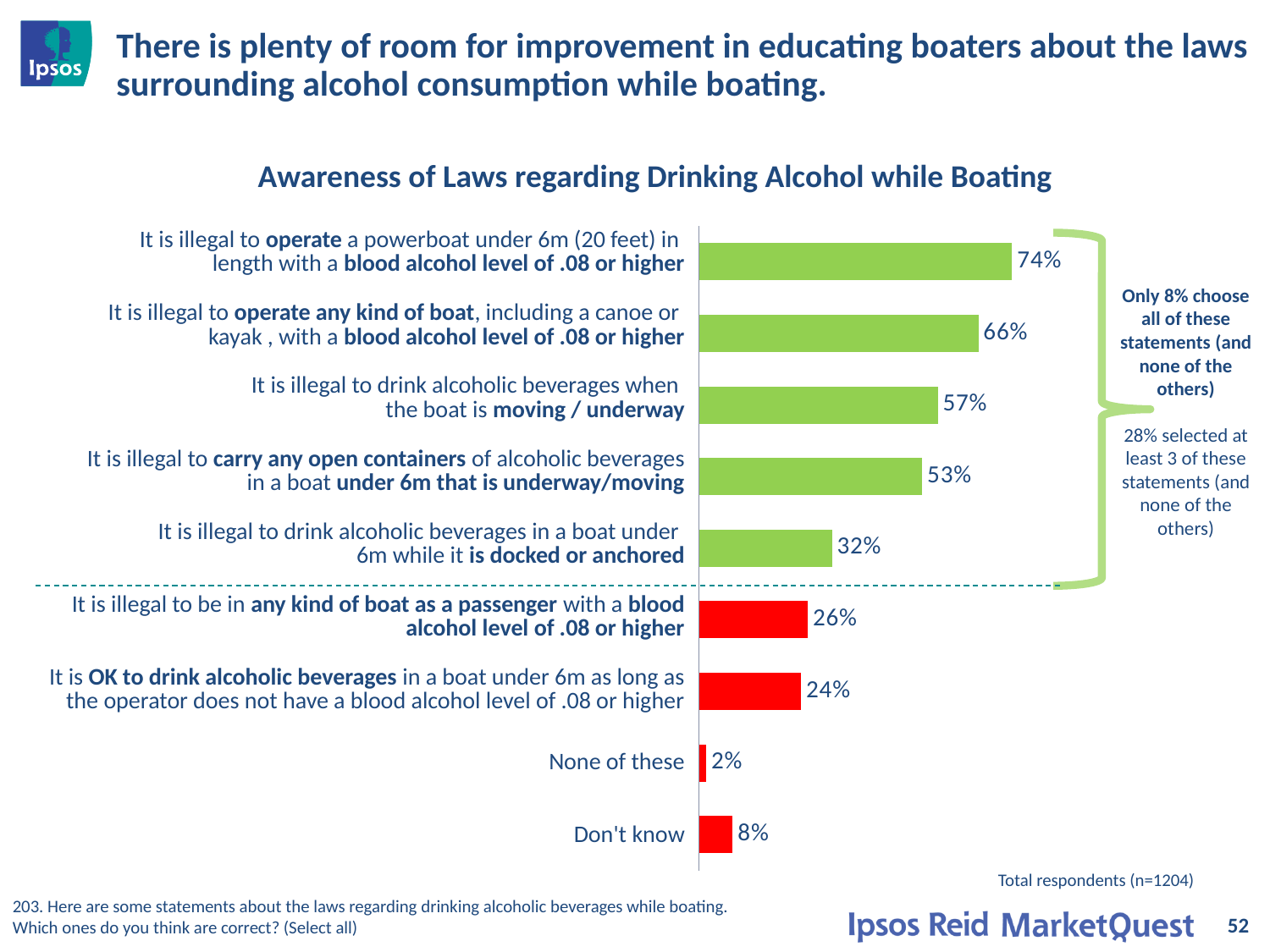
According to the annotation on the chart, what percentage of respondents chose all of the green statements and none of the others? 8% What percentage of respondents said it is illegal to drink alcoholic beverages in a boat under 6m while it is docked or anchored? 32% Which category has the lowest percentage? None of these What percentage of respondents selected 'Don't know'? 8% What is the title of the chart? Awareness of Laws regarding Drinking Alcohol while Boating What percentage of respondents said it is illegal to drink alcoholic beverages when the boat is moving / underway? 57% How many categories are shown in the chart? 9 What is the difference in percentage points between the 'operate any kind of boat' statement (66%) and the 'carry any open containers' statement (53%)? 13 What percentage of respondents said it is illegal to operate a powerboat under 6m in length with a blood alcohol level of .08 or higher? 74% Which statement has the highest percentage of respondents? It is illegal to operate a powerboat under 6m (20 feet) in length with a blood alcohol level of .08 or higher Which has a higher percentage: the statement about being a passenger with a blood alcohol level of .08 or higher, or the statement that it is OK to drink alcoholic beverages as long as the operator is under .08? The passenger statement (26%) What type of chart is shown on the slide? Bar chart